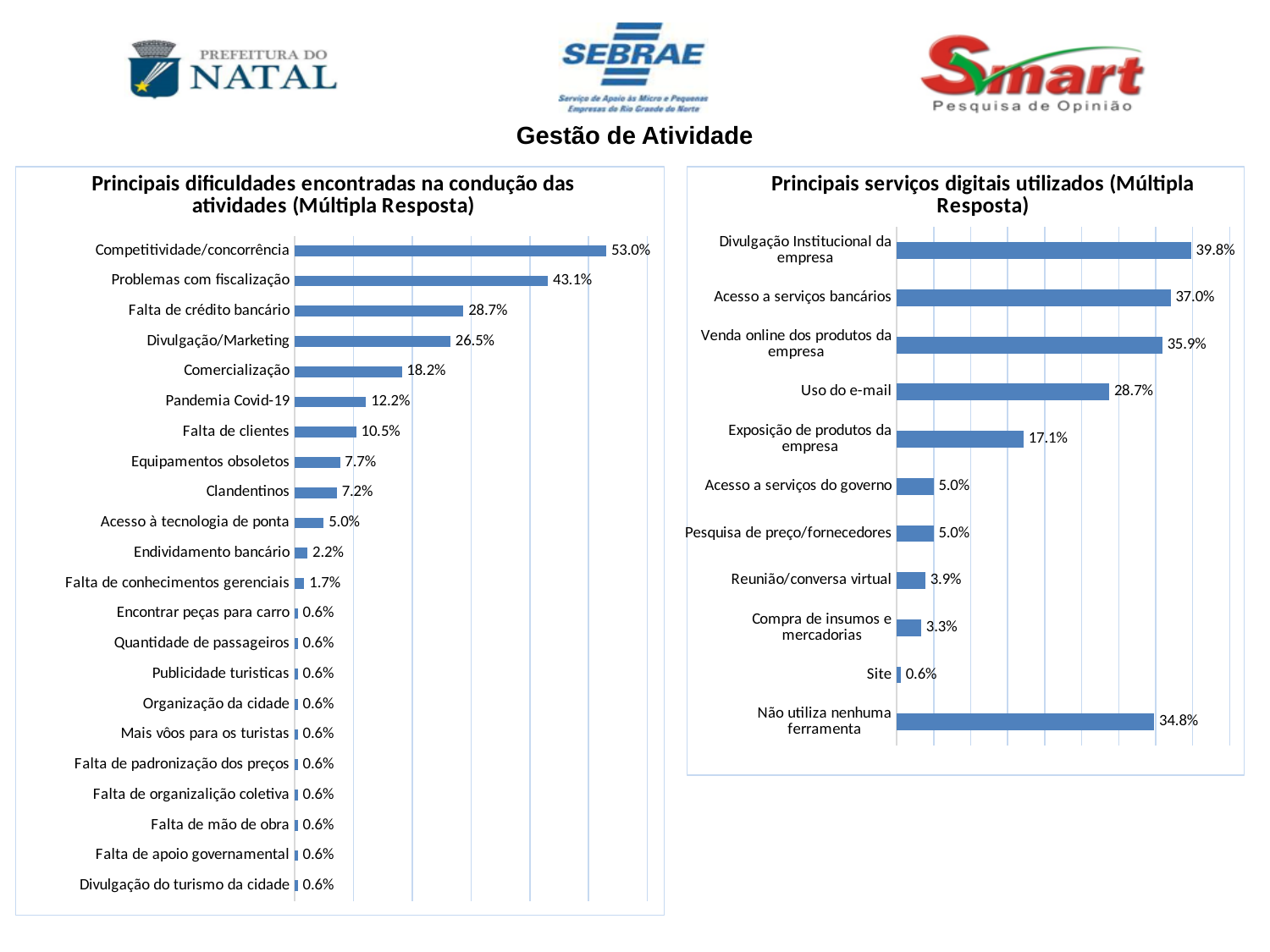
In the chart 'Principais dificuldades encontradas na condução das atividades', what is the difference between Competitividade/concorrência and Problemas com fiscalização? 9.9% In the chart 'Principais serviços digitais utilizados', which category has the lowest value? Site In the chart 'Principais serviços digitais utilizados', what is the value for Não utiliza nenhuma ferramenta? 34.8% In the chart 'Principais dificuldades encontradas na condução das atividades', which category has the highest value? Competitividade/concorrência In the chart 'Principais dificuldades encontradas na condução das atividades', how many categories are shown? 22 In the chart 'Principais serviços digitais utilizados', how many categories are shown? 11 In the chart 'Principais serviços digitais utilizados', which category has the highest value? Divulgação Institucional da empresa In the chart 'Principais dificuldades encontradas na condução das atividades', what is the value for Competitividade/concorrência? 53.0% In the chart 'Principais serviços digitais utilizados', what is the value for Uso do e-mail? 28.7% In the chart 'Principais dificuldades encontradas na condução das atividades', what is the value for Pandemia Covid-19? 12.2% In the chart 'Principais dificuldades encontradas na condução das atividades', which is larger: Falta de crédito bancário or Divulgação/Marketing? Falta de crédito bancário What type of chart is 'Principais serviços digitais utilizados'? Bar chart